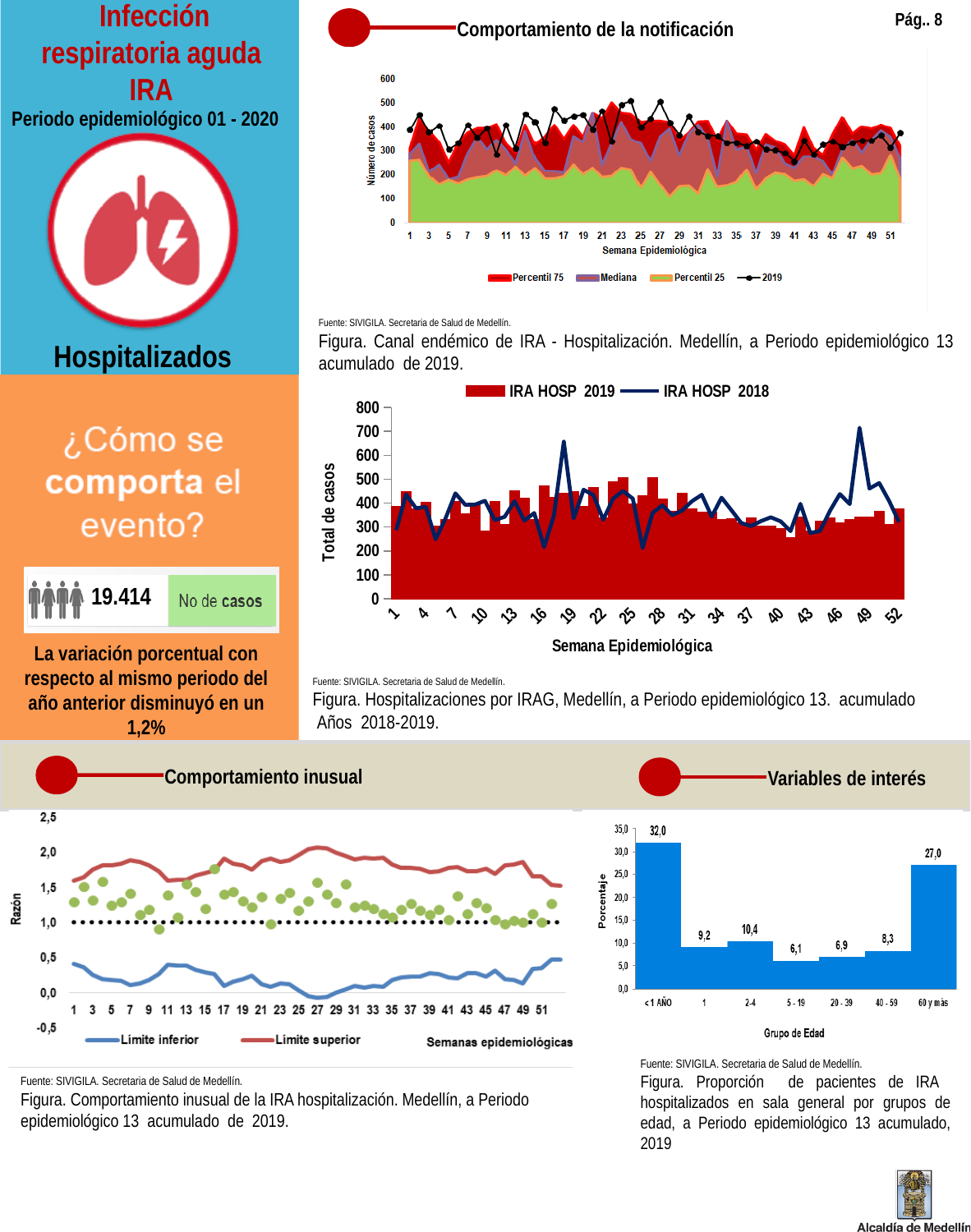
In the bar chart by age group (bottom right), which age group has the lowest percentage? 5 - 19 In the bar chart by age group (bottom right), what is the percentage for the '60 y más' group? 27,0 How many series does the legend list in the 'Canal endémico de IRA - Hospitalización' chart at the top right? 4 In the bar chart of proportion of IRA hospitalized patients by age group (bottom right), what is the value for the '< 1 AÑO' group? 32,0 How many series does the legend list in the 'IRA HOSP' chart in the middle of the slide? 2 In the bar chart by age group (bottom right), which is larger: the value for '2-4' or the value for '40 - 59'? 2-4 In the bar chart by age group (bottom right), what is the difference between the '< 1 AÑO' value and the '60 y más' value? 5,0 How many age groups are shown in the bar chart at the bottom right? 7 In the 'IRA HOSP' chart in the middle of the slide, is the peak value of the IRA HOSP 2018 line around week 48 greater or less than 600? greater In the bar chart by age group (bottom right), which age group has the highest percentage? < 1 AÑO In the 'Comportamiento inusual' chart at the bottom left, what are the two series named in the legend? Límite inferior and Límite superior What kind of chart is the 'Grupo de Edad' chart at the bottom right? Bar chart